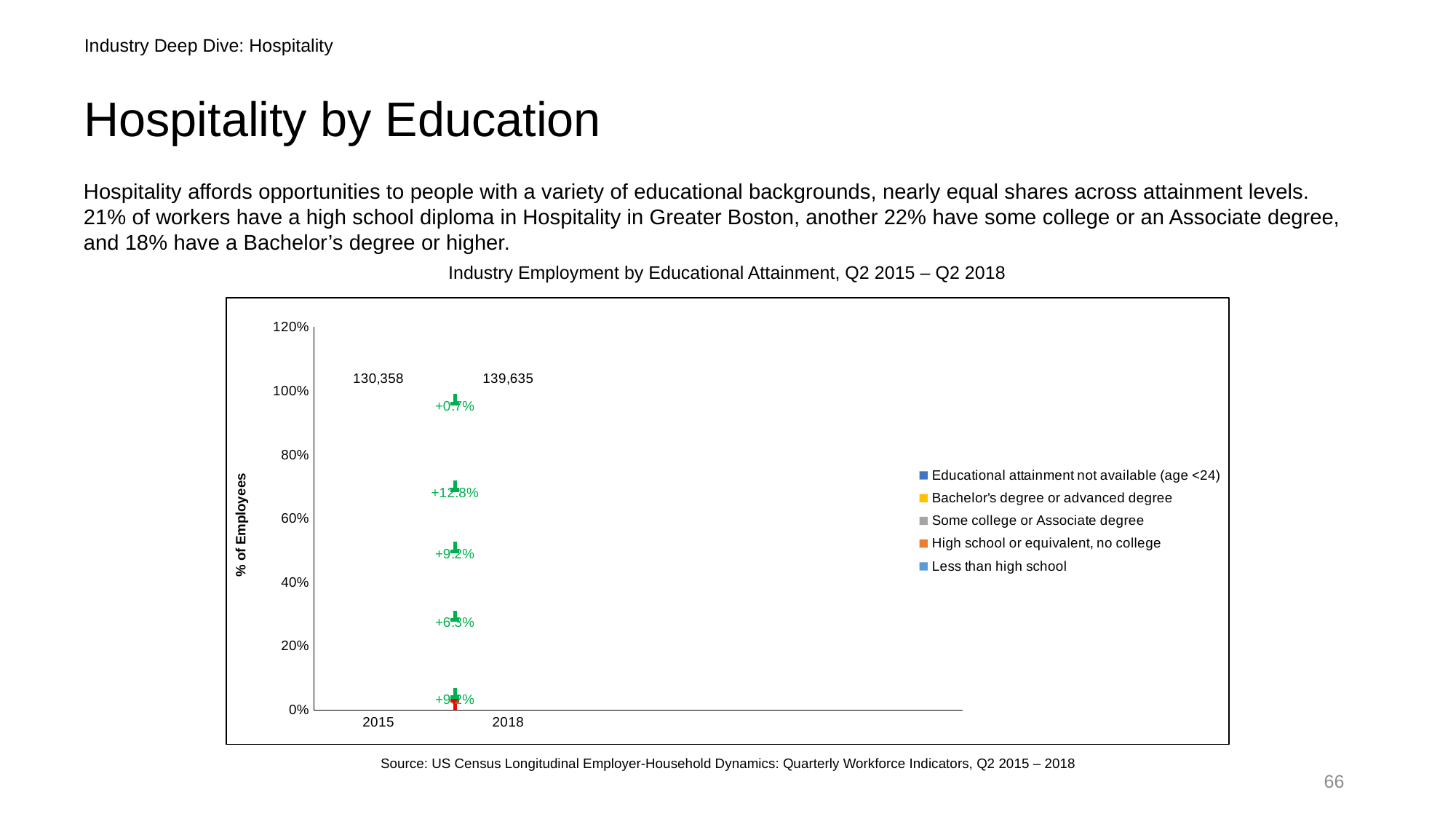
How many series does the legend list? 5 Is the 2018 total employment figure greater or less than 140,000? less What total employment figure is printed above the 2018 column? 139,635 What total employment figure is printed above the 2015 column? 130,358 What is the smallest percentage change annotation shown in green between the 2015 and 2018 columns? +0.7% What is the largest percentage change annotation shown in green between the 2015 and 2018 columns? +12.8% What is the title of the chart? Industry Employment by Educational Attainment, Q2 2015 – Q2 2018 What is the difference between the 2018 total (139,635) and the 2015 total (130,358)? 9,277 What is the label on the y axis? % of Employees How many years are shown on the x axis? 2 Is the 2015 total employment figure greater or less than 130,000? greater Which year has the larger total employment figure, 2015 or 2018? 2018